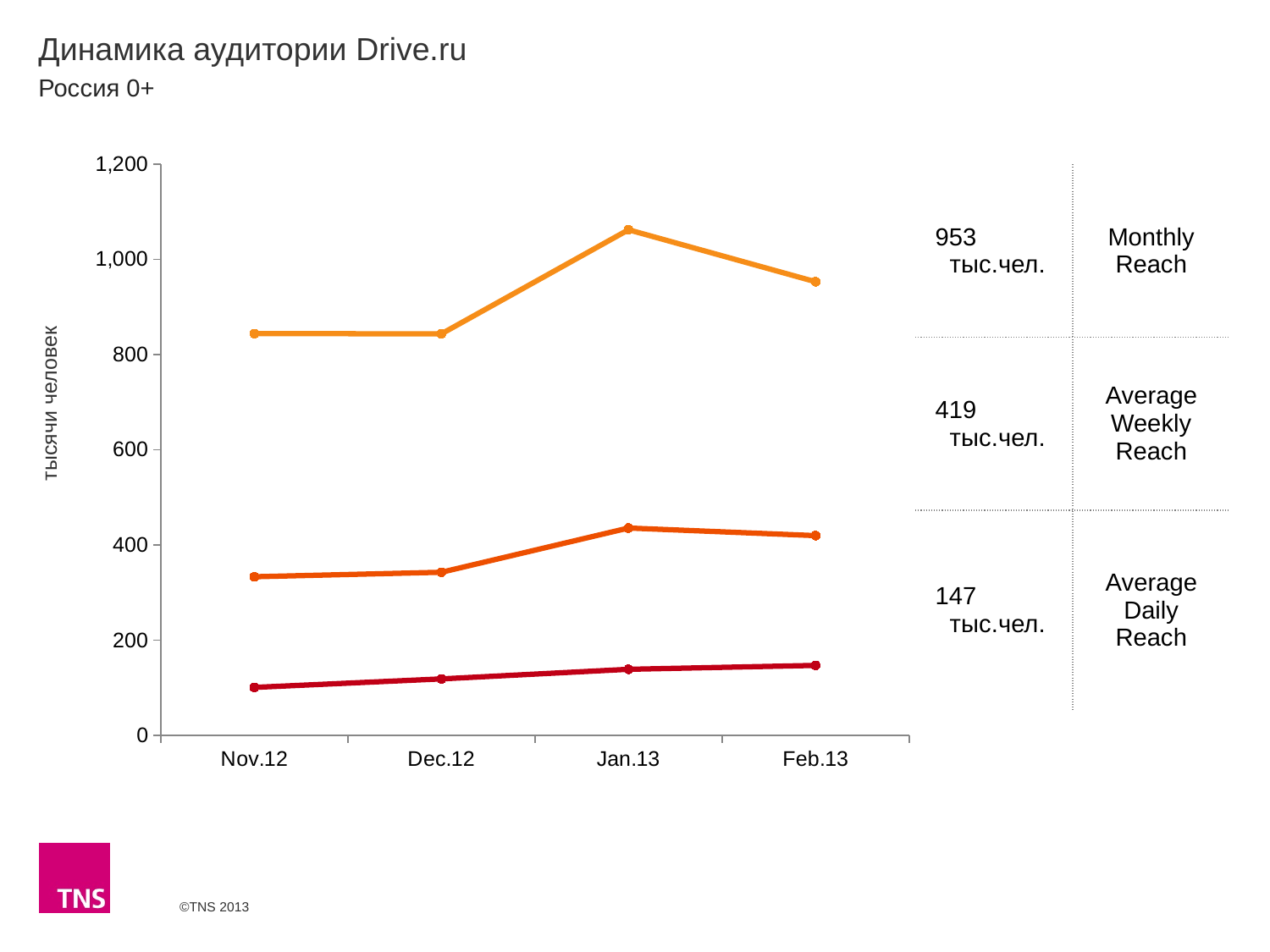
What is the label of the vertical axis? тысячи человек In which month is the Average Daily Reach line at its lowest? Nov.12 What kind of chart is shown on the slide? line chart In which month does the Monthly Reach line reach its highest point? Jan.13 Is the Monthly Reach value for Jan.13 greater or less than 1,000? greater Does the Average Daily Reach line rise or fall from Nov.12 to Feb.13? rise What Average Weekly Reach value is printed on the slide? 419 тыс.чел. Is the Average Weekly Reach value for Nov.12 greater or less than 400? less How many time points are plotted along the x axis? 4 What is the title of the slide chart? Динамика аудитории Drive.ru What Monthly Reach value is printed on the slide? 953 тыс.чел. What Average Daily Reach value is printed on the slide? 147 тыс.чел.